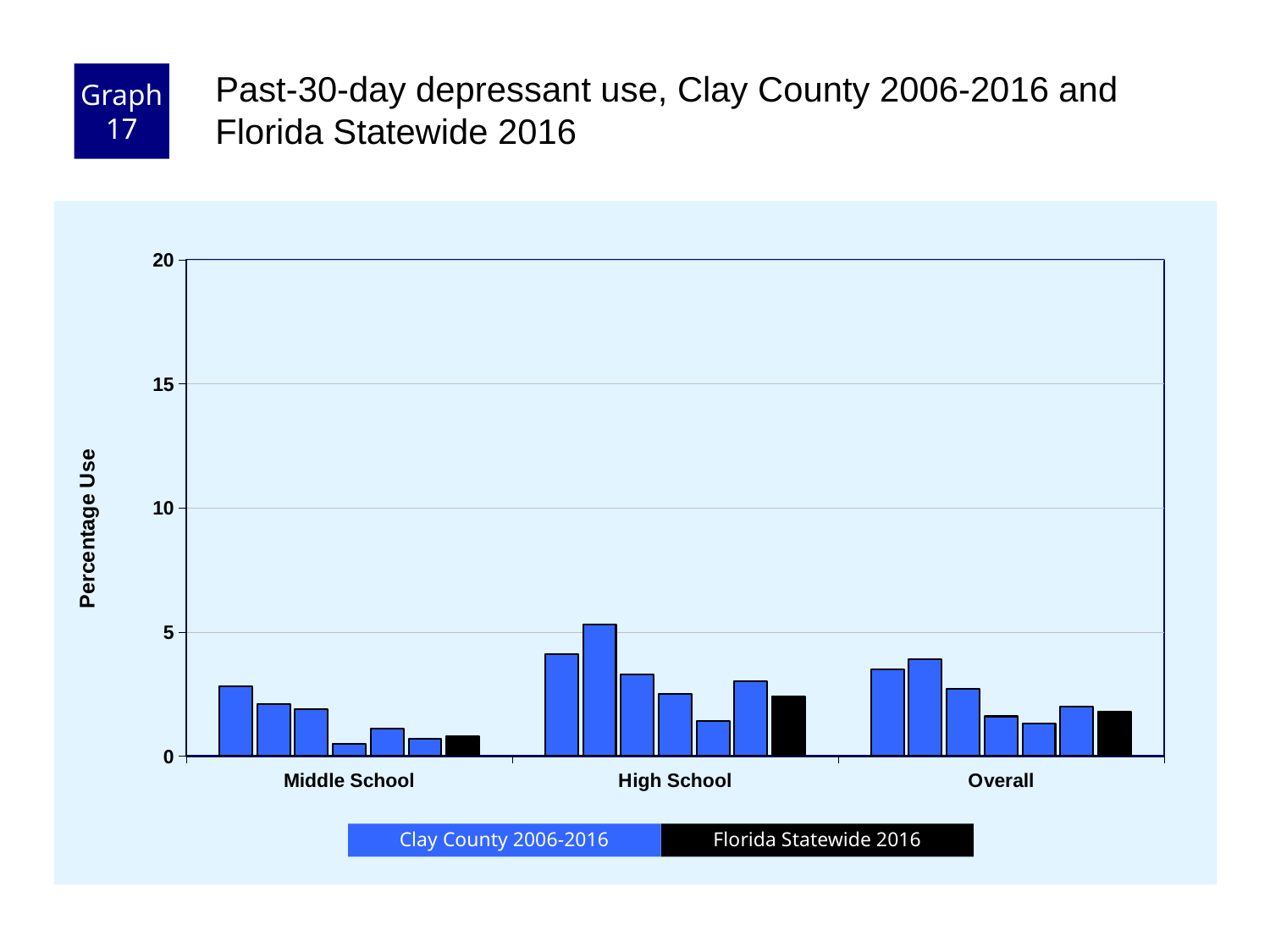
What is the label on the y axis of the chart? Percentage Use Is the Florida Statewide 2016 value for Middle School greater or less than 5? less How many categories are shown on the x axis of the chart? 3 Which is larger: the Florida Statewide 2016 bar for High School or the Florida Statewide 2016 bar for Middle School? High School Which is larger: the Florida Statewide 2016 bar for Overall or the Florida Statewide 2016 bar for Middle School? Overall What colour are the Florida Statewide 2016 bars in the chart? black How many series does the chart legend list? 2 Is the Florida Statewide 2016 value for High School greater or less than 5? less What kind of chart is shown on the slide? bar chart Which category on the x axis contains the tallest bar in the chart? High School What is the highest value shown on the y axis of the chart? 20 Are all the bars in the chart greater or less than 10? less